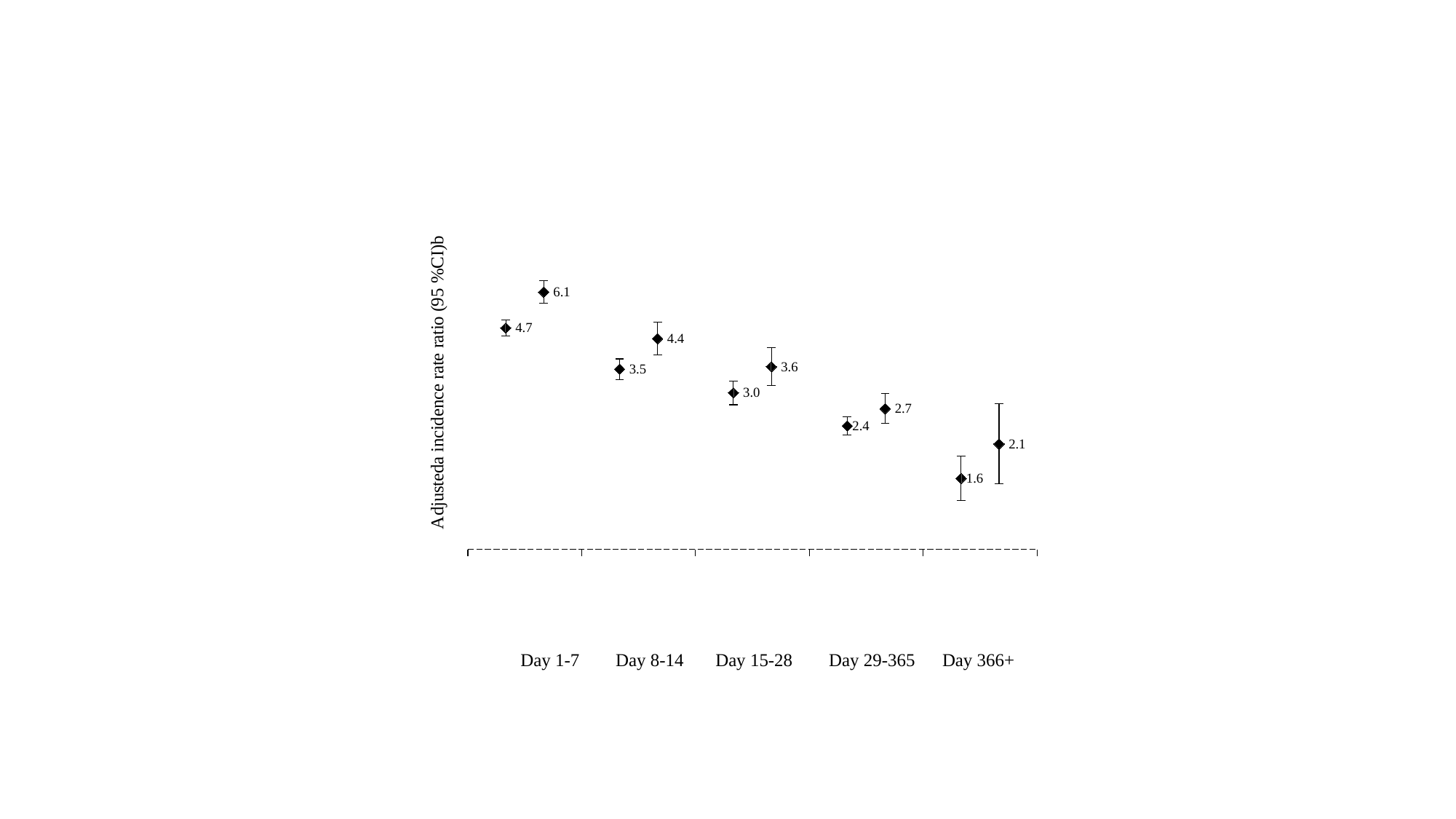
Do the plotted values rise or fall from Day 1-7 to Day 366+? fall Which category contains the highest plotted value? Day 1-7 Which is larger: the left-hand point for Day 29-365 or the left-hand point for Day 366+? Day 29-365 What is the value of the right-hand point for Day 366+? 2.1 Which category contains the lowest plotted value? Day 366+ What is the difference between the two points plotted for Day 1-7? 1.4 What is the value of the left-hand point for Day 1-7? 4.7 What is the value of the right-hand point for Day 8-14? 4.4 What is the y-axis title of the chart? Adjusteda incidence rate ratio (95 %CI)b How many day-range categories are shown on the x axis? 5 What is the value of the right-hand point for Day 1-7? 6.1 What is the value of the left-hand point for Day 15-28? 3.0